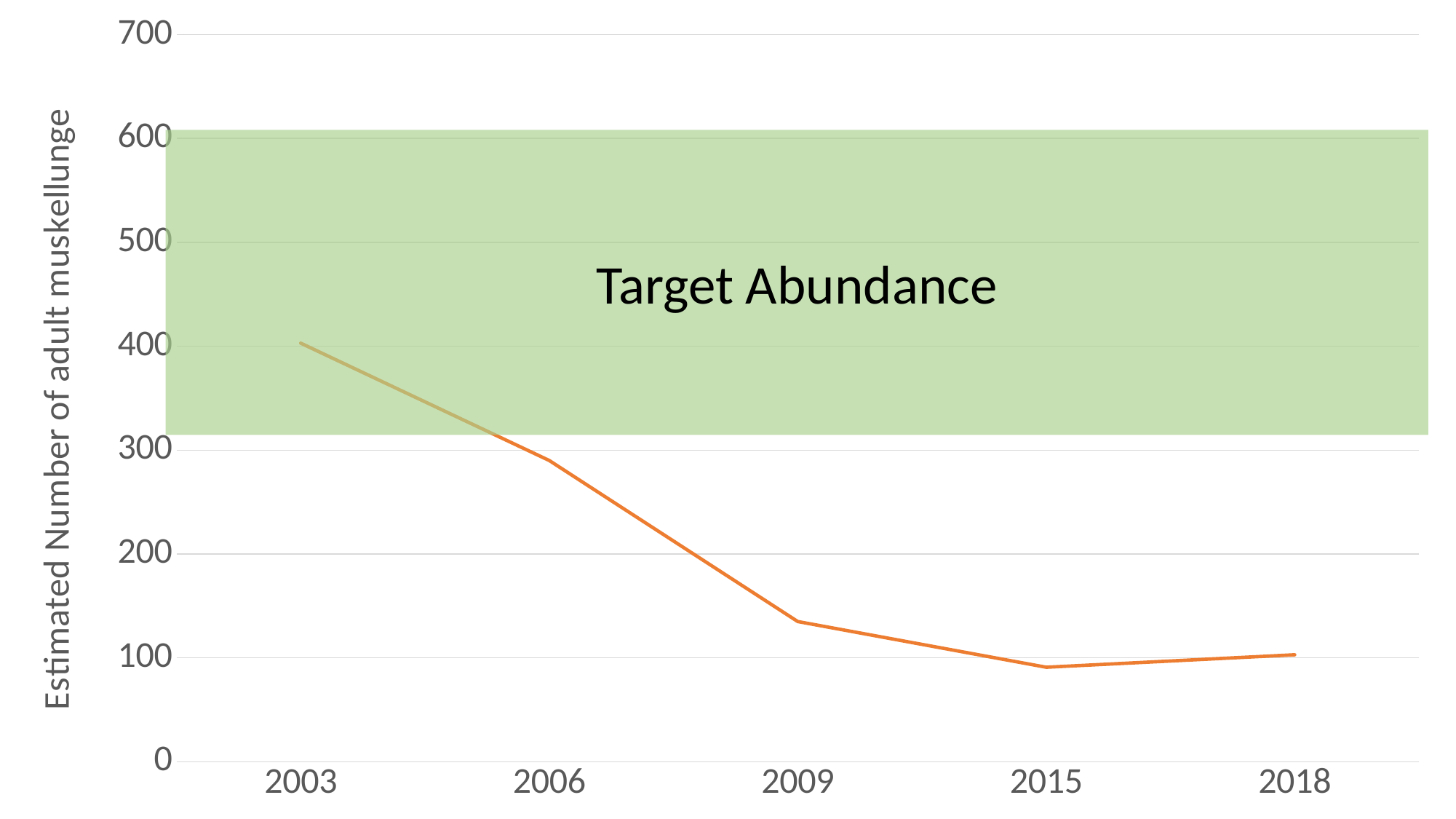
Is the value for 2006 greater or less than 200? greater Does the estimated number of adult muskellunge generally rise or fall from 2003 to 2018? fall How many years are plotted along the x axis? 5 Which year has the highest estimated number of adult muskellunge? 2003 Which year has a larger value, 2003 or 2009? 2003 Which year has a larger value, 2006 or 2015? 2006 Is the value for 2009 greater or less than 200? less Is the value for 2003 greater or less than 500? less What is the label of the green shaded band on the chart? Target Abundance Which year has the lowest estimated number of adult muskellunge? 2015 What kind of chart is shown on the slide? line chart